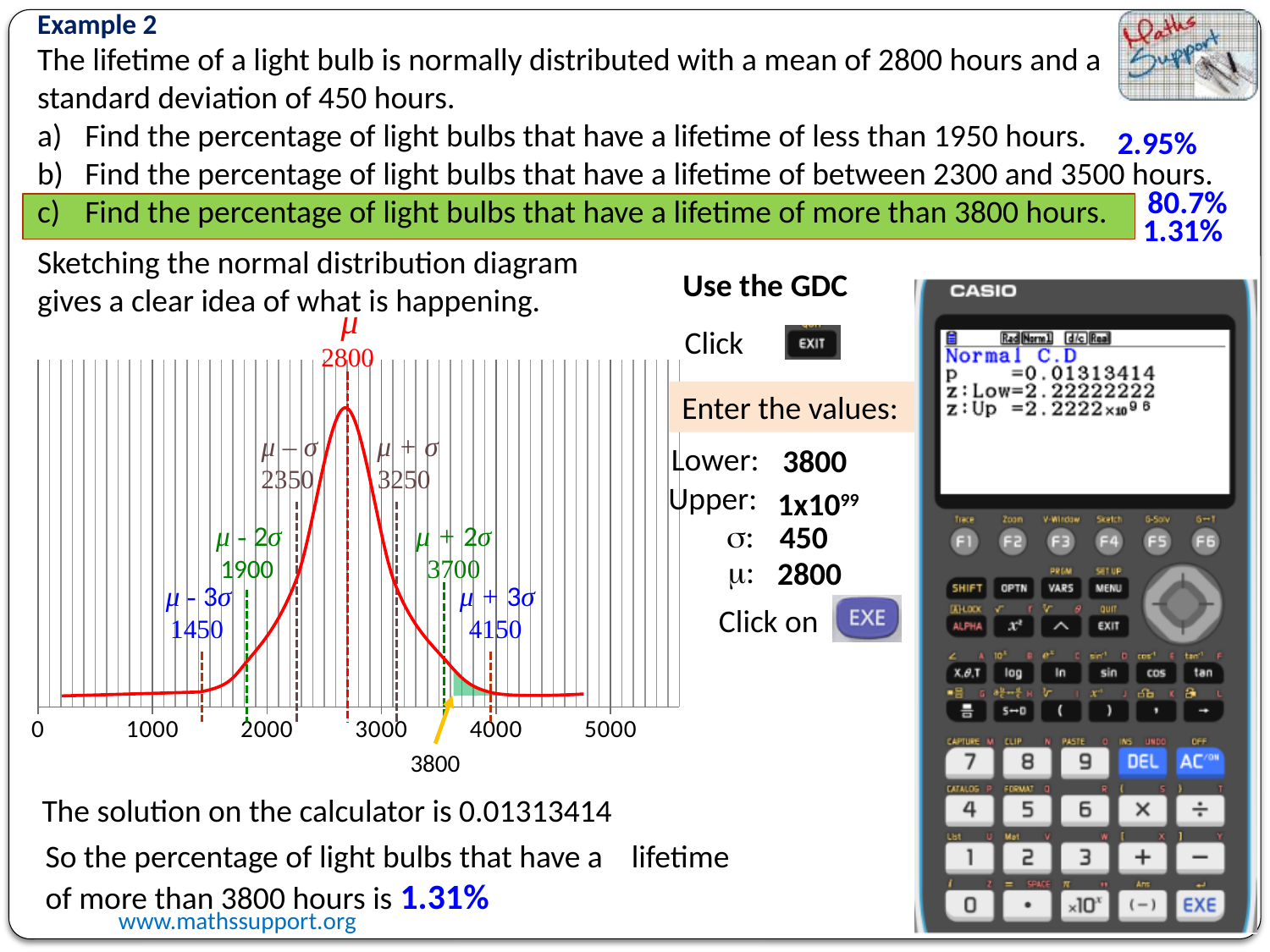
What is the largest tick label shown on the x axis of the diagram? 5000 What value is labelled at μ − 2σ on the normal distribution diagram? 1900 What value does the arrow below the x axis of the diagram point to? 3800 What value is labelled at the mean μ on the normal distribution diagram? 2800 What value is labelled at μ + 3σ on the normal distribution diagram? 4150 What value is labelled at μ − 3σ on the normal distribution diagram? 1450 Does the curve rise or fall as the x axis goes from 2800 to 4000? fall What value is labelled at μ − σ on the normal distribution diagram? 2350 Which is larger on the diagram, the value at μ + 2σ or the value at μ + σ? μ + 2σ (3700) What is the difference between the values labelled at μ + σ and μ − σ on the diagram? 900 What kind of chart is the normal distribution diagram on the slide? line chart What value is labelled at μ + σ on the normal distribution diagram? 3250